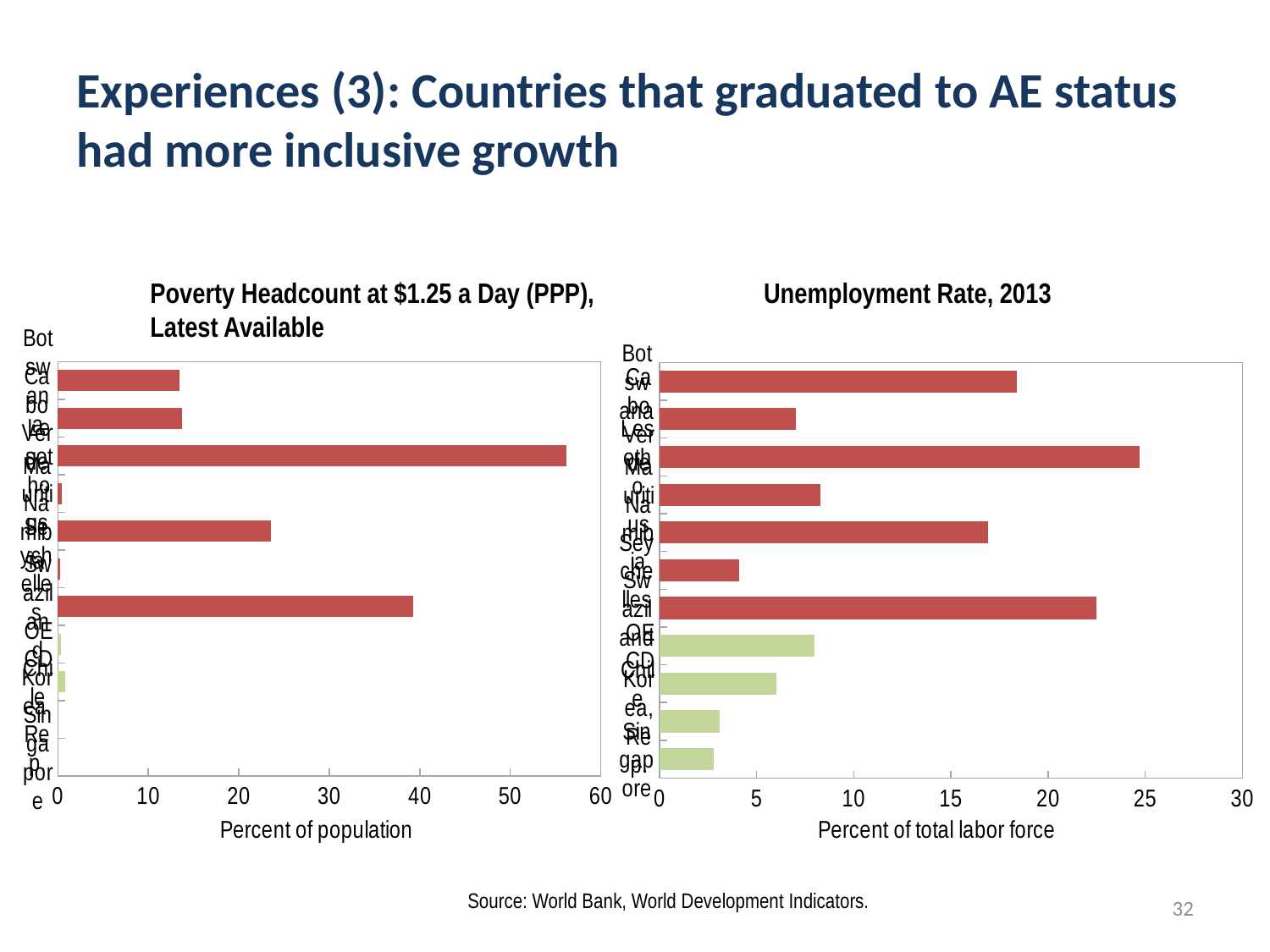
What kind of chart is the Poverty Headcount at $1.25 a Day (PPP) chart on the left? bar chart In the Poverty Headcount chart on the left, is the value of the second bar from the top greater or less than 20? less What kind of chart is the Unemployment Rate, 2013 chart on the right? bar chart In the Unemployment Rate, 2013 chart, is the value of the topmost bar greater or less than 15? greater What is the x-axis title of the Unemployment Rate, 2013 chart? Percent of total labor force In the Unemployment Rate, 2013 chart, is the value of the longest bar greater or less than 20? greater In the Unemployment Rate, 2013 chart, which bar is the longest, counting from the top? the third bar from the top In the Unemployment Rate, 2013 chart, how many bars are plotted? 11 What is the x-axis title of the Poverty Headcount chart on the left? Percent of population In the Unemployment Rate, 2013 chart, which is larger: the topmost bar or the second bar from the top? the topmost bar